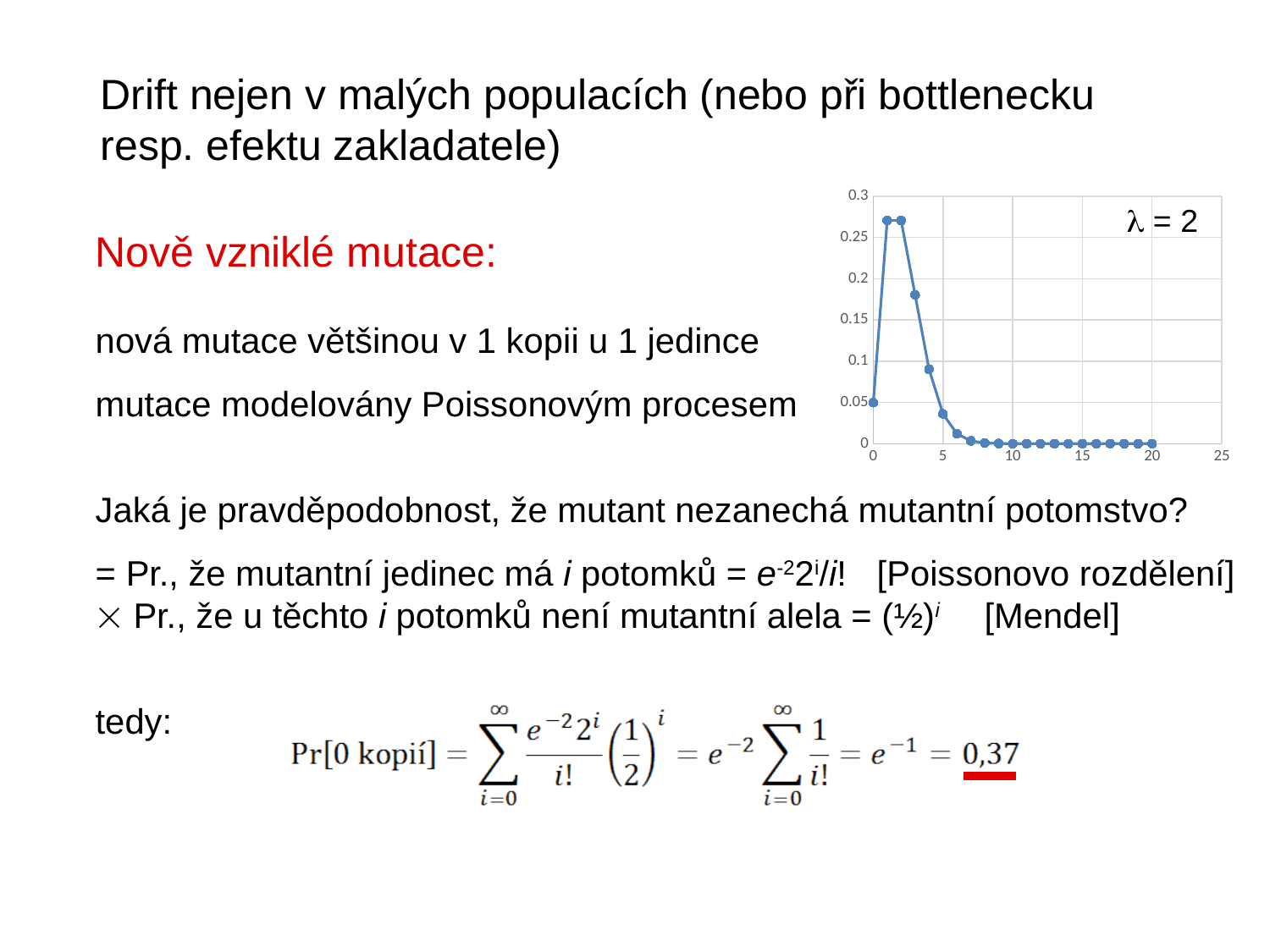
What kind of chart is shown on the slide? line chart From x = 2 to x = 20, do the plotted values rise or fall? fall Is the plotted value at x = 3 greater or less than 0.15? greater Is the plotted value at x = 0 greater or less than 0.1? less Which has the larger plotted value, x = 3 or x = 5? x = 3 What is the highest tick value shown on the chart's y axis? 0.3 Is the plotted value at x = 4 greater or less than 0.1? less Which has the larger plotted value, x = 2 or x = 4? x = 2 How many data points are plotted on the chart? 21 What parameter value is annotated in the top-right corner of the chart? λ = 2